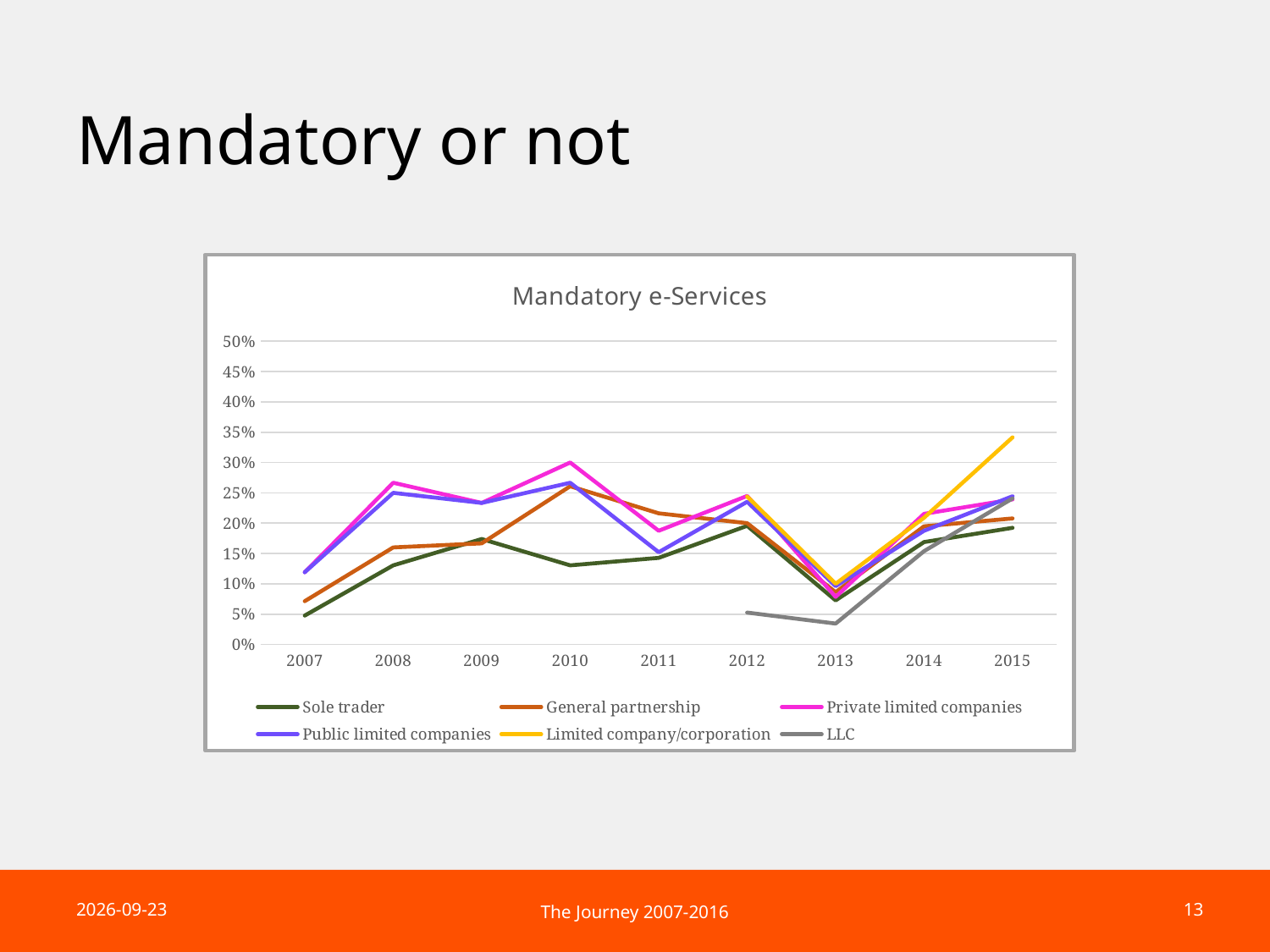
Which series has the highest value in 2015? Limited company/corporation How many years are shown on the x axis of the chart? 9 How many series does the legend of the chart list? 6 Is the value for Sole trader in 2007 greater or less than 10%? less What is the title of the chart? Mandatory e-Services In 2008, which is larger: the value for Private limited companies or the value for Sole trader? Private limited companies Which series has the highest value in 2010? Private limited companies What kind of chart is shown on the slide? line chart Is the value for Limited company/corporation in 2015 greater or less than 30%? greater Is the value for LLC in 2013 greater or less than 10%? less Which series has the lowest value in 2013? LLC